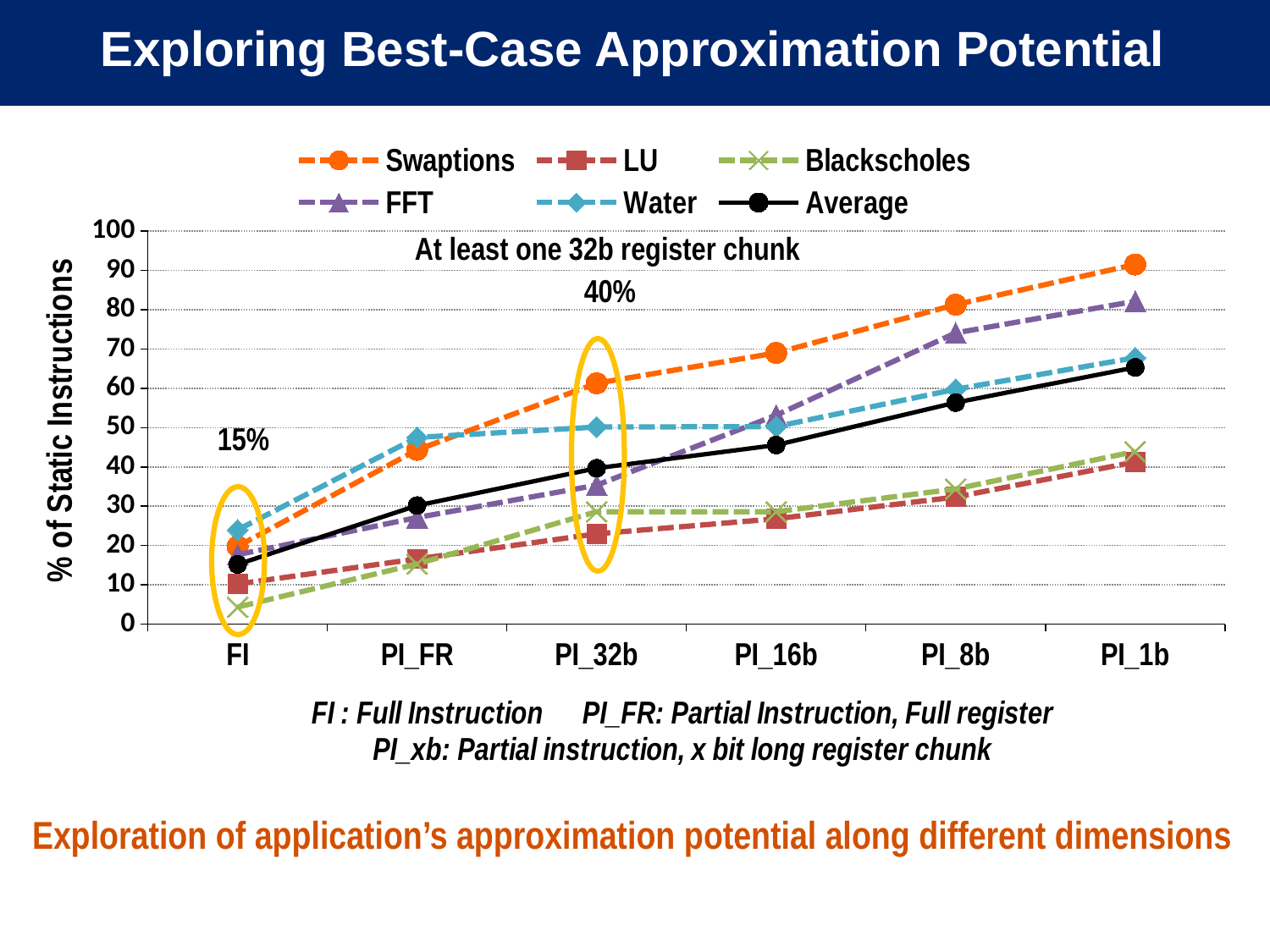
Is the value for Swaptions at PI_1b greater or less than 80? greater Which series has the highest value at PI_1b? Swaptions What value is annotated for the Average series at PI_32b? 40% Is the value for LU at PI_16b greater or less than 40? less What is the label of the y axis? % of Static Instructions How many categories are shown along the x axis? 6 Which is larger at PI_8b, the value for FFT or the value for Water? FFT How many series does the legend list? 6 What kind of chart is shown on the slide? line chart Does the Average series rise or fall from FI to PI_1b? rise What value is annotated for the Average series at FI? 15% Which series has the lowest value at FI? Blackscholes